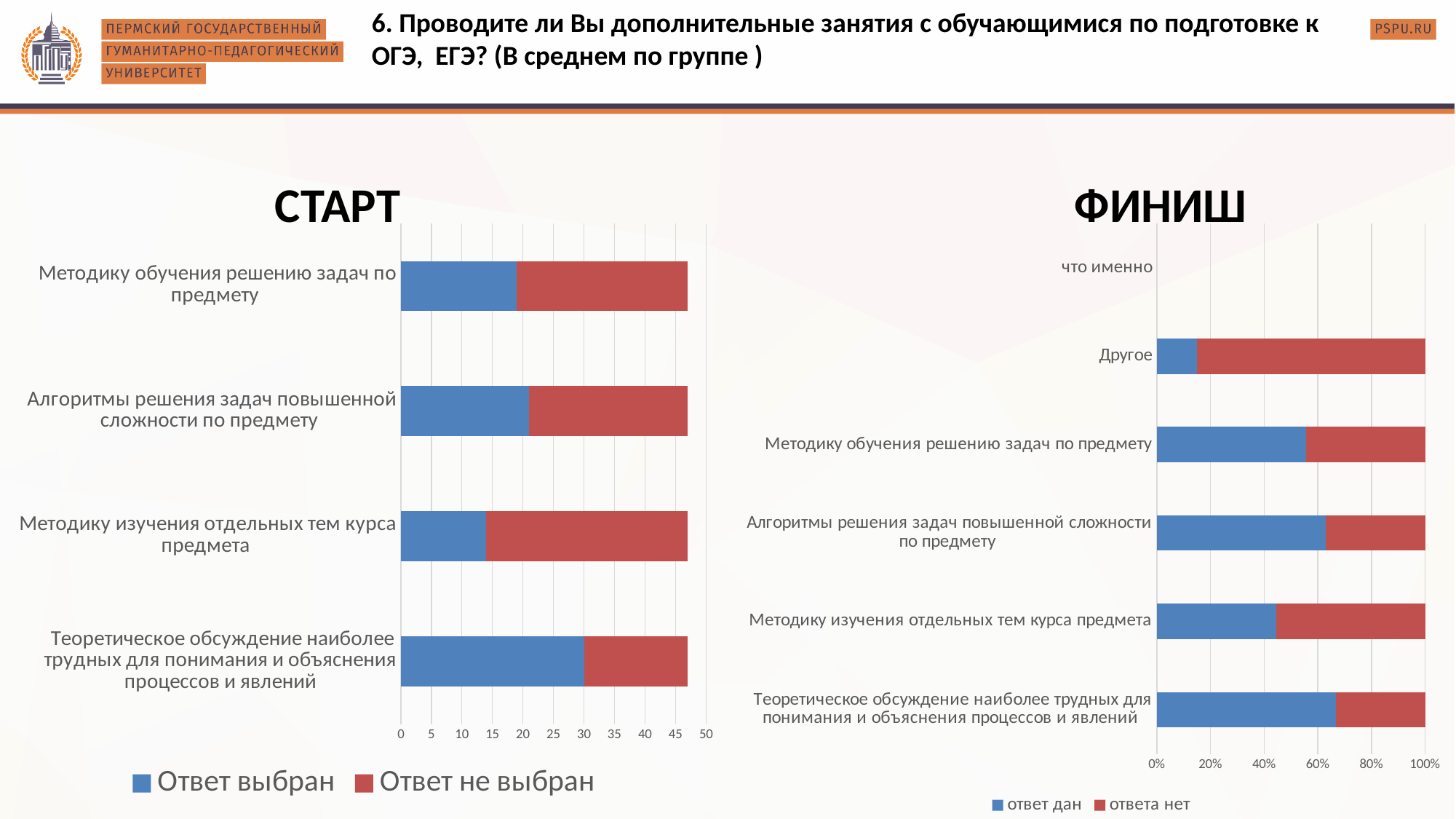
How many series does the legend of the ФИНИШ chart list? 2 On the ФИНИШ chart, is the 'ответ дан' share for 'Другое' greater or less than 20%? less On the СТАРТ chart, which category has the smallest 'Ответ выбран' value? Методику изучения отдельных тем курса предмета What are the two legend entries of the СТАРТ chart? Ответ выбран, Ответ не выбран How many series does the legend of the СТАРТ chart list? 2 How many categories are shown on the СТАРТ chart? 4 On the СТАРТ chart, is the 'Ответ выбран' value for 'Теоретическое обсуждение наиболее трудных для понимания и объяснения процессов и явлений' greater or less than 25? greater What kind of chart is the СТАРТ chart? bar chart On the СТАРТ chart, is the 'Ответ выбран' value for 'Методику изучения отдельных тем курса предмета' greater or less than 20? less On the СТАРТ chart, which category has the largest 'Ответ выбран' value? Теоретическое обсуждение наиболее трудных для понимания и объяснения процессов и явлений On the ФИНИШ chart, which has the larger 'ответ дан' share: 'Методику обучения решению задач по предмету' or 'Методику изучения отдельных тем курса предмета'? Методику обучения решению задач по предмету On the ФИНИШ chart, which category has the smallest 'ответ дан' share? Другое